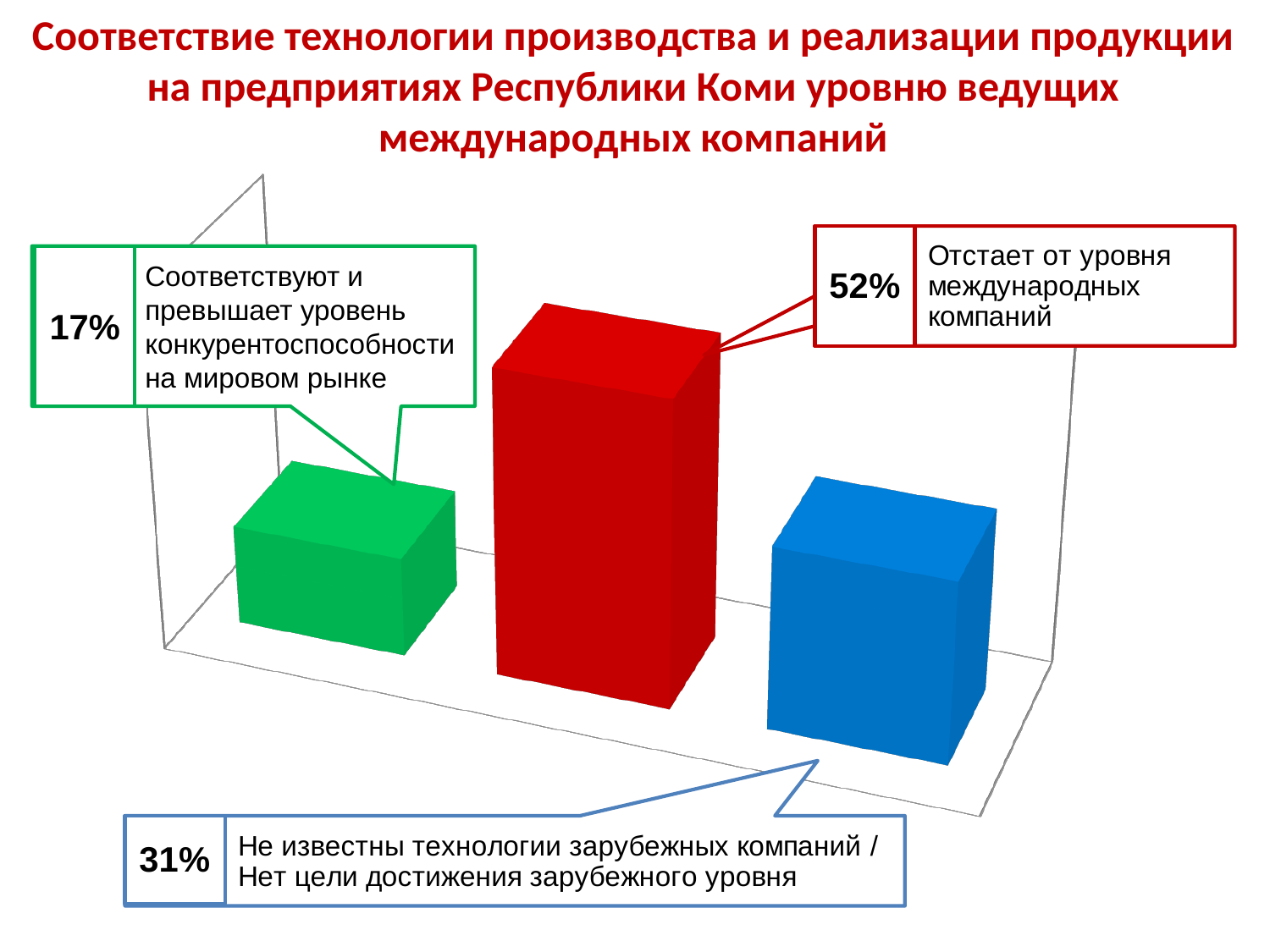
What value is shown for the category "Не известны технологии зарубежных компаний / Нет цели достижения зарубежного уровня"? 31% What colour is the bar representing 31%? Blue What is the difference between the red bar (52%) and the blue bar (31%)? 21% What is the difference between the value for "Отстает от уровня международных компаний" and the value for "Соответствуют и превышает уровень конкурентоспособности на мировом рынке"? 35% How many bars are plotted on the chart? 3 What percentage of enterprises is shown for the category "Отстает от уровня международных компаний"? 52% Which category has the highest value on the chart? Отстает от уровня международных компаний Which is larger: the value for "Не известны технологии зарубежных компаний" or the value for "Соответствуют и превышает уровень конкурентоспособности на мировом рынке"? Не известны технологии зарубежных компаний What colour is the bar representing 52%? Red What kind of chart is shown on the slide? Bar chart What value is shown for the green bar ("Соответствуют и превышает уровень конкурентоспособности на мировом рынке")? 17% Which category has the lowest value on the chart? Соответствуют и превышает уровень конкурентоспособности на мировом рынке